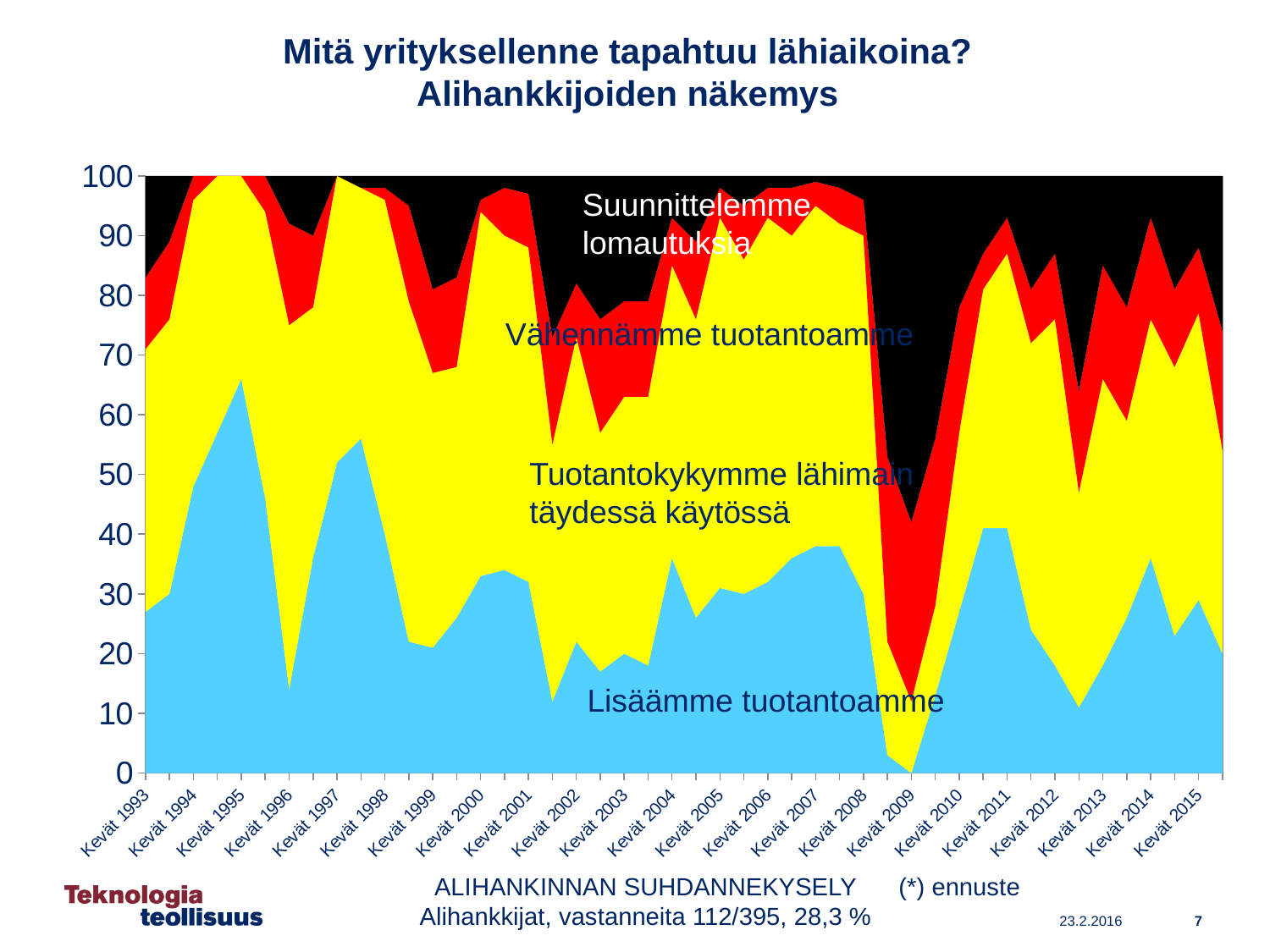
Is the value for Lisäämme tuotantoamme at Kevät 2009 greater or less than 10? less Is the value for Lisäämme tuotantoamme at Kevät 1996 greater or less than 20? less At which x-axis label does the Lisäämme tuotantoamme series reach its highest value? Kevät 1995 How many series (response categories) are labelled in the chart? 4 What kind of chart is shown on the slide? Stacked area chart How many year labels (Kevät 1993 to Kevät 2015) are shown on the x axis? 23 Which series is drawn in light blue at the bottom of the chart? Lisäämme tuotantoamme Is the value for Lisäämme tuotantoamme at Kevät 1995 greater or less than 60? greater Does the Lisäämme tuotantoamme series rise or fall from Kevät 2011 to Kevät 2013? Fall At which x-axis label does the Lisäämme tuotantoamme series reach its lowest value? Kevät 2009 Which series is drawn in black at the top of the chart? Suunnittelemme lomautuksia